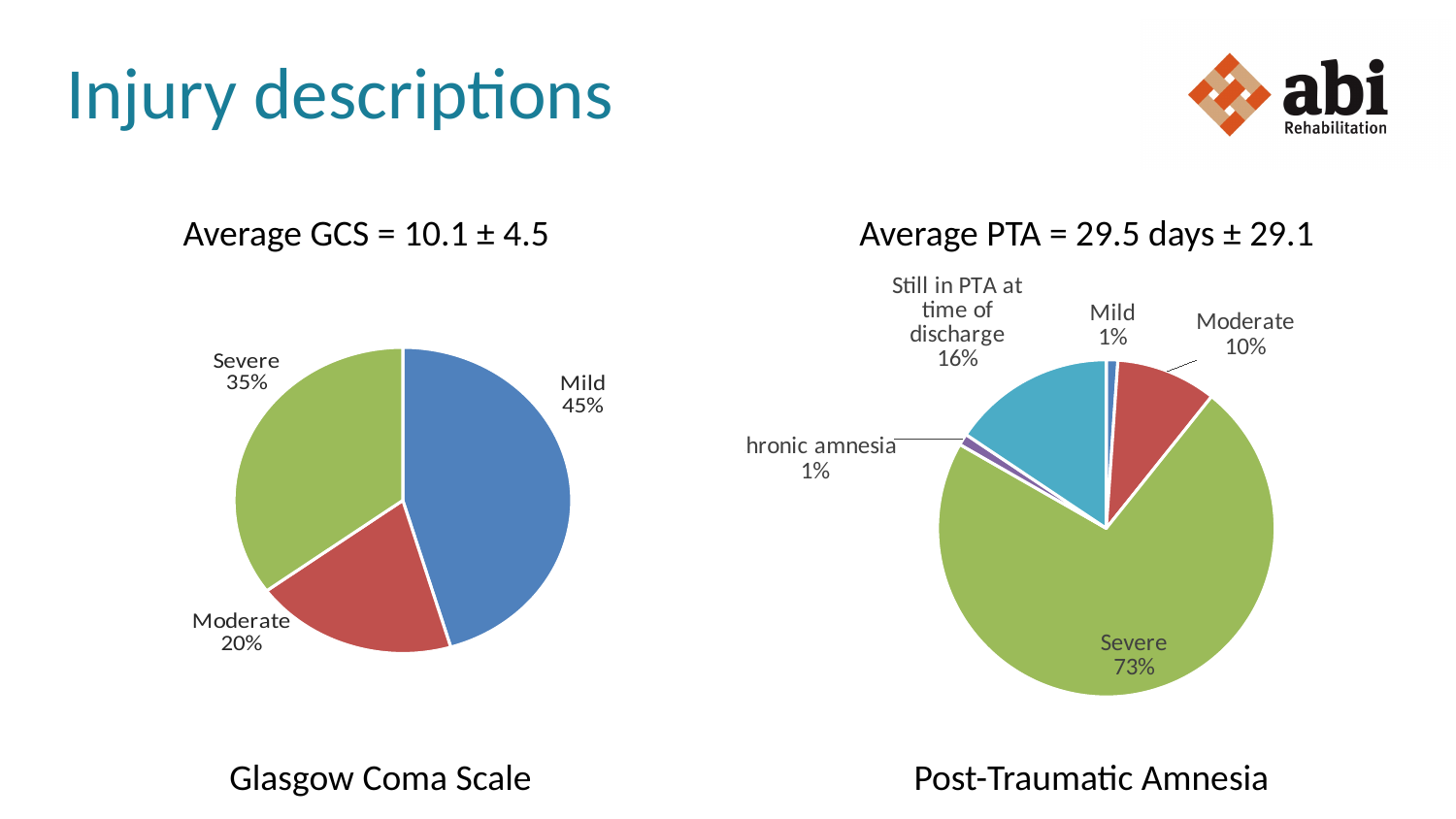
In the Post-Traumatic Amnesia pie chart, what percentage is labelled 'Still in PTA at time of discharge'? 16% In the Glasgow Coma Scale pie chart, which category has the smallest slice? Moderate In the Post-Traumatic Amnesia pie chart, is the Moderate slice larger or smaller than the 'Still in PTA at time of discharge' slice? smaller What type of chart is used for the Glasgow Coma Scale data? pie chart In the Glasgow Coma Scale pie chart, what percentage is labelled Mild? 45% In the Glasgow Coma Scale pie chart, which category has the largest slice? Mild How many slices does the Post-Traumatic Amnesia pie chart have? 5 In the Glasgow Coma Scale pie chart, what percentage is labelled Moderate? 20% In the Post-Traumatic Amnesia pie chart, what percentage is labelled Moderate? 10% In the Post-Traumatic Amnesia pie chart, which category has the largest slice? Severe In the Post-Traumatic Amnesia pie chart, what percentage is labelled Severe? 73% In the Glasgow Coma Scale pie chart, what is the difference between the Severe and Moderate percentages? 15%